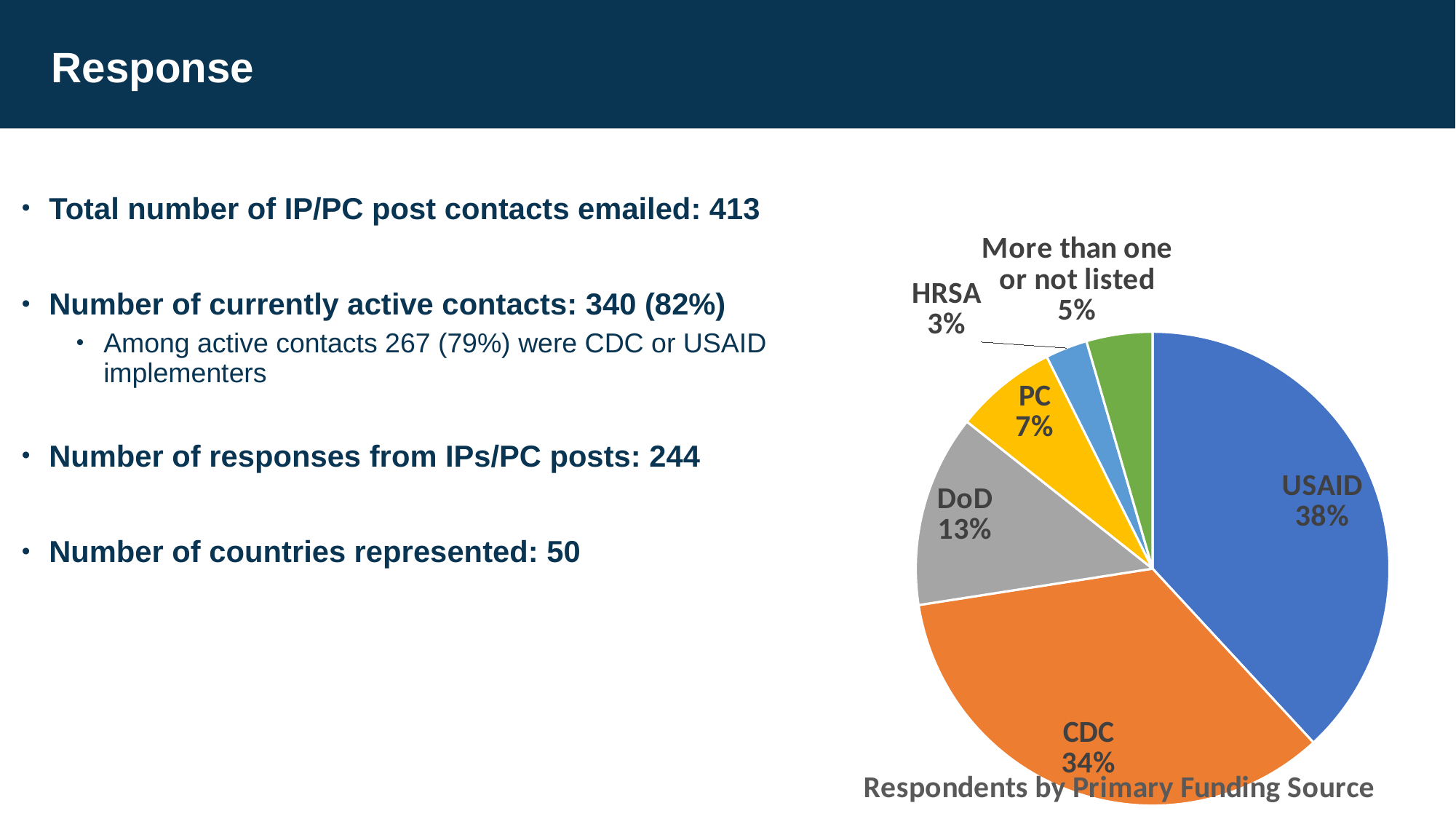
Which primary funding source has the largest share of respondents? USAID What share of respondents have DoD as their primary funding source? 13% What share of respondents fall under 'More than one or not listed'? 5% Which primary funding source has the smallest share of respondents? HRSA What is the title of the chart? Respondents by Primary Funding Source How many slices does the pie chart have? 6 What is the difference in percentage points between the USAID and CDC shares? 4 What kind of chart is shown on the slide? Pie chart What share of respondents have USAID as their primary funding source? 38% What share of respondents have CDC as their primary funding source? 34% Which has a larger share of respondents, DoD or PC? DoD What share of respondents have HRSA as their primary funding source? 3%